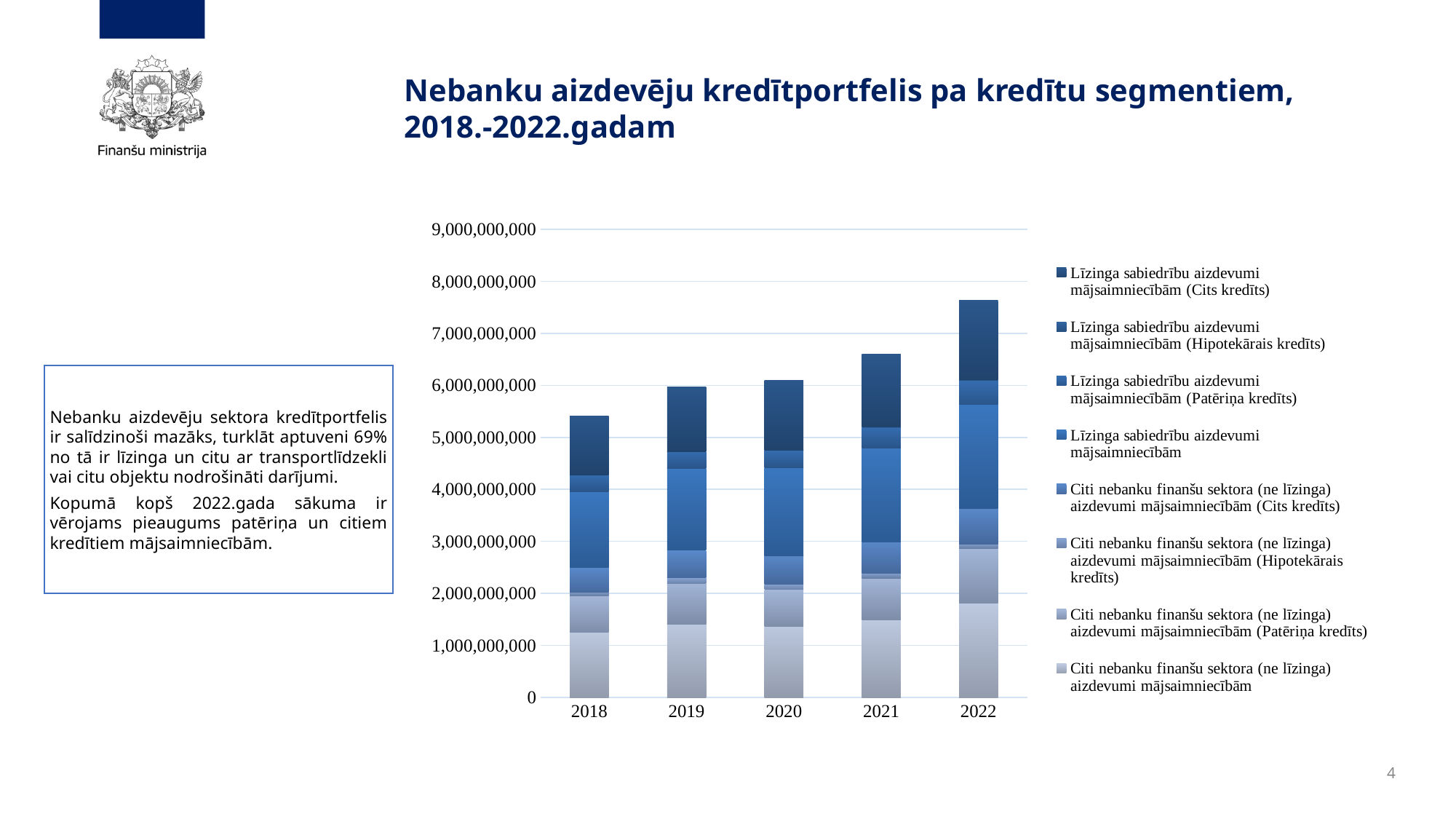
Which year has the shortest stacked bar? 2018 Do the total bar heights rise or fall from 2018 to 2022? Rise Which year has the larger total bar, 2019 or 2021? 2021 Which year has the tallest stacked bar? 2022 Is the total value of the 2022 bar greater or less than 7,000,000,000? greater Is the total value of the 2021 bar greater or less than 6,000,000,000? greater How many years are shown on the x axis of the chart? 5 What is the title of the chart on the slide? Nebanku aizdevēju kredītportfelis pa kredītu segmentiem, 2018.-2022.gadam Is the total value of the 2018 bar greater or less than 5,000,000,000? greater What kind of chart is shown on the slide? Stacked bar chart What is the highest value shown on the chart's vertical axis? 9,000,000,000 How many series does the chart's legend list? 8